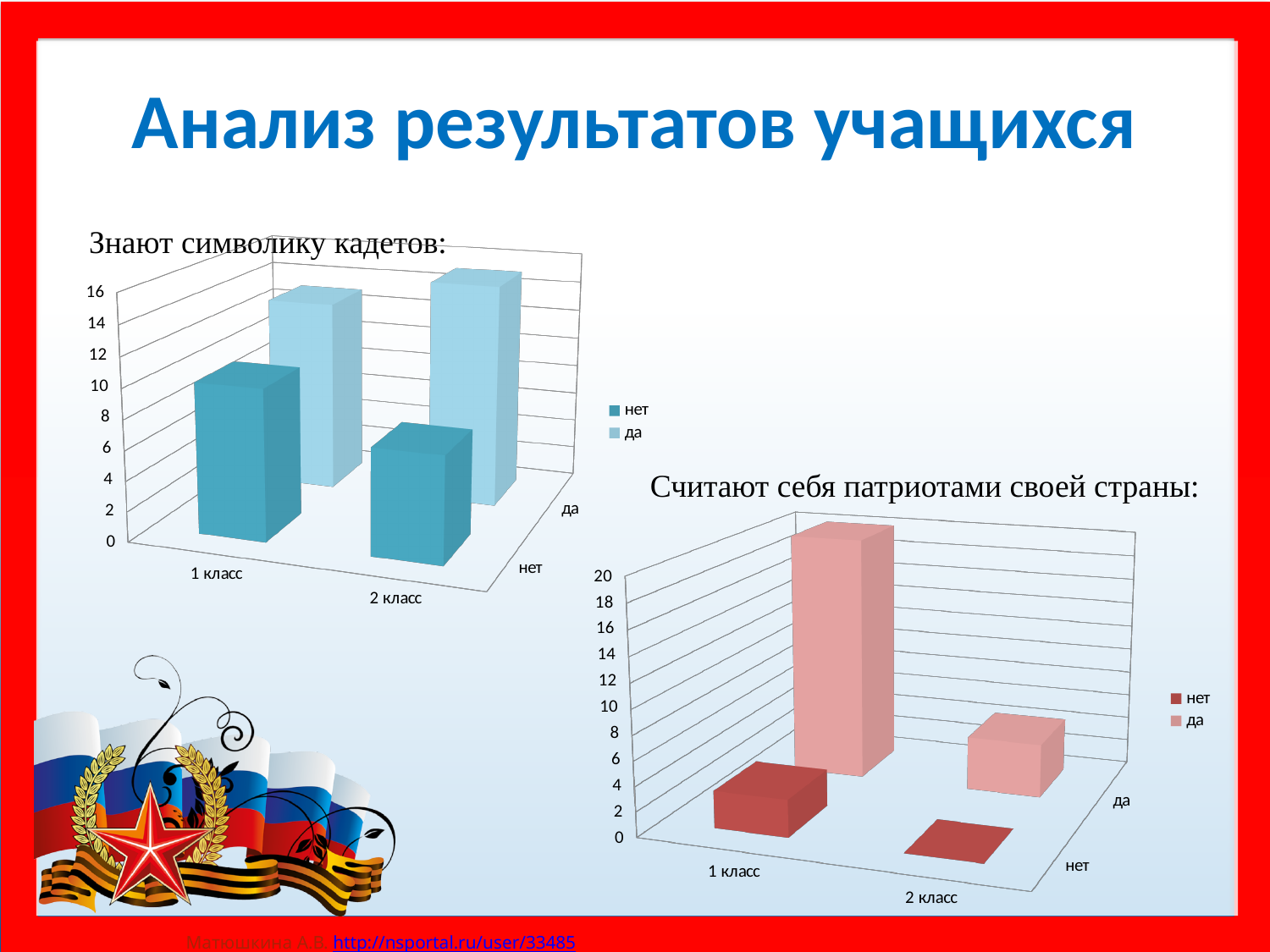
What are the legend entries of the chart "Считают себя патриотами своей страны:"? нет, да In the chart "Считают себя патриотами своей страны:", which bar is the tallest? да for 1 класс In the chart "Считают себя патриотами своей страны:", which bar is the shortest? нет for 2 класс In the chart "Знают символику кадетов:", how many series does the legend list? 2 In the chart "Знают символику кадетов:", which bar is the shortest? нет for 2 класс In the chart "Считают себя патриотами своей страны:", is the value of нет for 2 класс greater or less than 4? less In the chart "Знают символику кадетов:", which bar is the tallest? да for 2 класс What kind of chart is the chart titled "Знают символику кадетов:"? bar chart In the chart "Считают себя патриотами своей страны:", how many categories are shown on the x axis? 2 In the chart "Считают себя патриотами своей страны:", is the value of да for 1 класс greater or less than 10? greater In the chart "Знают символику кадетов:", for 2 класс, which is larger: да or нет? да What kind of chart is the chart titled "Считают себя патриотами своей страны:"? bar chart